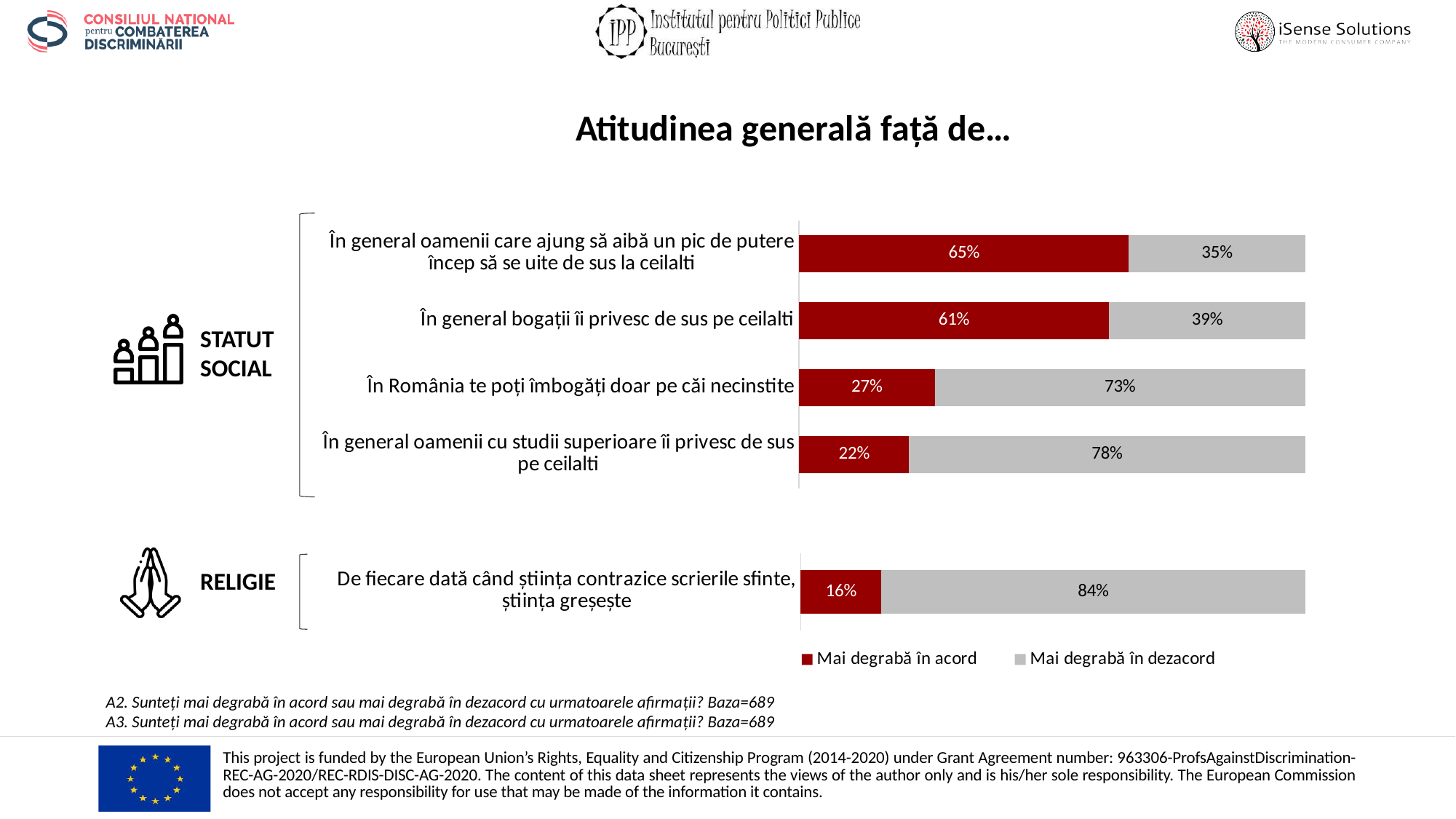
How many statements are plotted in the chart? 5 What kind of chart is shown on the slide? Stacked bar chart Which is larger: the 'Mai degrabă în acord' value for 'În România te poți îmbogăți doar pe căi necinstite' or for 'În general oamenii cu studii superioare îi privesc de sus pe ceilalti'? În România te poți îmbogăți doar pe căi necinstite What is the difference between the 'Mai degrabă în dezacord' values for 'În general oamenii cu studii superioare îi privesc de sus pe ceilalti' and 'În general bogații îi privesc de sus pe ceilalti'? 39% Which colour represents 'Mai degrabă în dezacord' in the chart? Grey What is the 'Mai degrabă în dezacord' value for the statement 'De fiecare dată când știința contrazice scrierile sfinte, știința greșește'? 84% What is the 'Mai degrabă în acord' value for 'În România te poți îmbogăți doar pe căi necinstite'? 27% What percentage of respondents are 'Mai degrabă în acord' with the statement 'În general bogații îi privesc de sus pe ceilalti'? 61% Which statement has the highest 'Mai degrabă în acord' share? În general oamenii care ajung să aibă un pic de putere încep să se uite de sus la ceilalti What is the total of the two segments in the bar for 'În general oamenii care ajung să aibă un pic de putere încep să se uite de sus la ceilalti'? 100% Which statement has the lowest 'Mai degrabă în acord' share? De fiecare dată când știința contrazice scrierile sfinte, știința greșește How many series does the legend list? 2